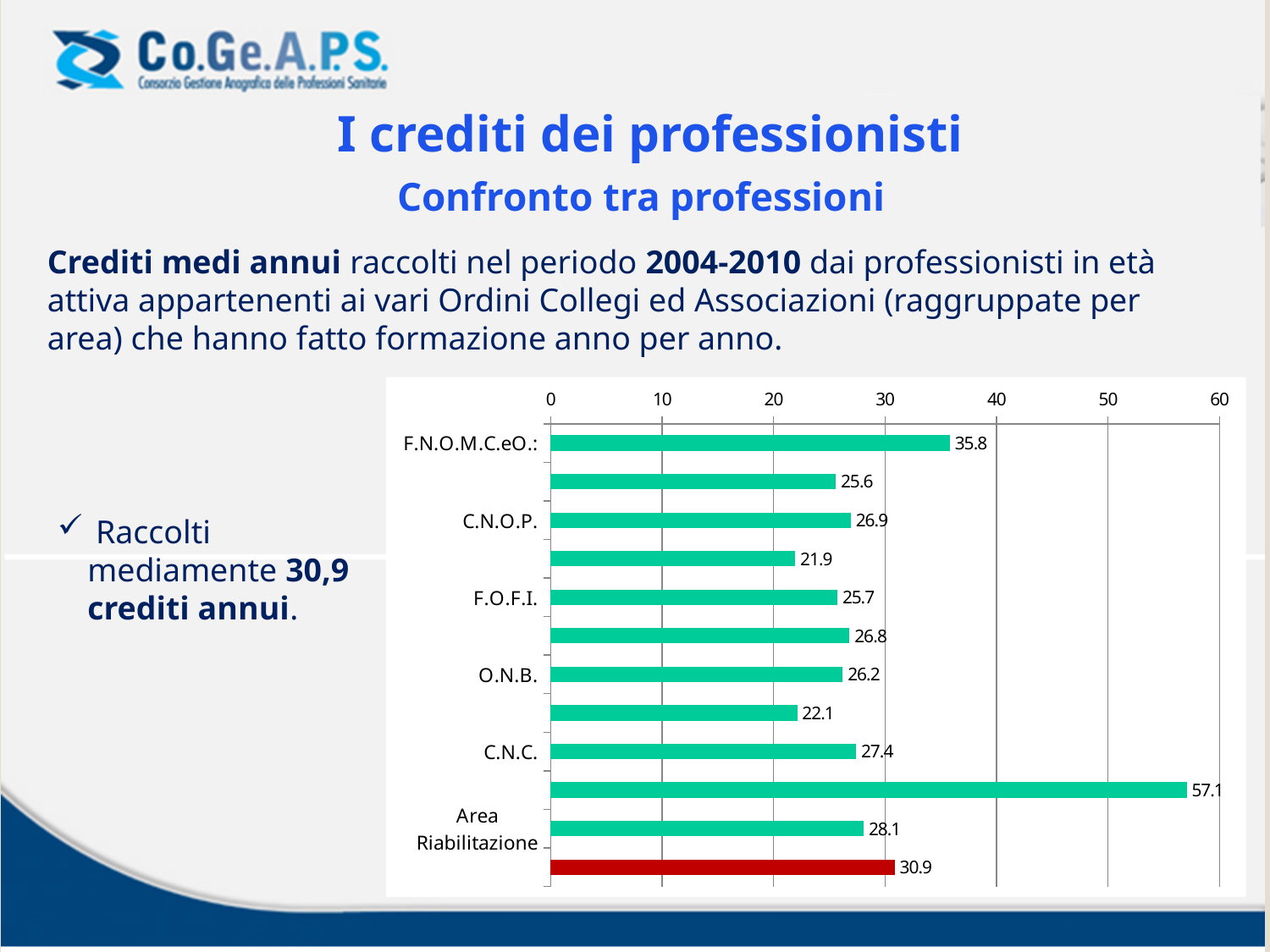
What is the highest value shown in the chart? 57.1 What is the lowest value shown in the chart? 21.9 What is the value for F.O.F.I. in the chart? 25.7 What is the value for Area Riabilitazione in the chart? 28.1 Which has a larger value, F.N.O.M.C.eO.: or C.N.C.? F.N.O.M.C.eO.: What type of chart is shown on the slide? Bar chart What is the value for F.N.O.M.C.eO.: in the chart? 35.8 What is the difference between the values for F.N.O.M.C.eO.: and C.N.O.P.? 8.9 What is the value for C.N.C. in the chart? 27.4 What is the value for C.N.O.P. in the chart? 26.9 How many bars are plotted in the chart? 12 What is the value for O.N.B. in the chart? 26.2